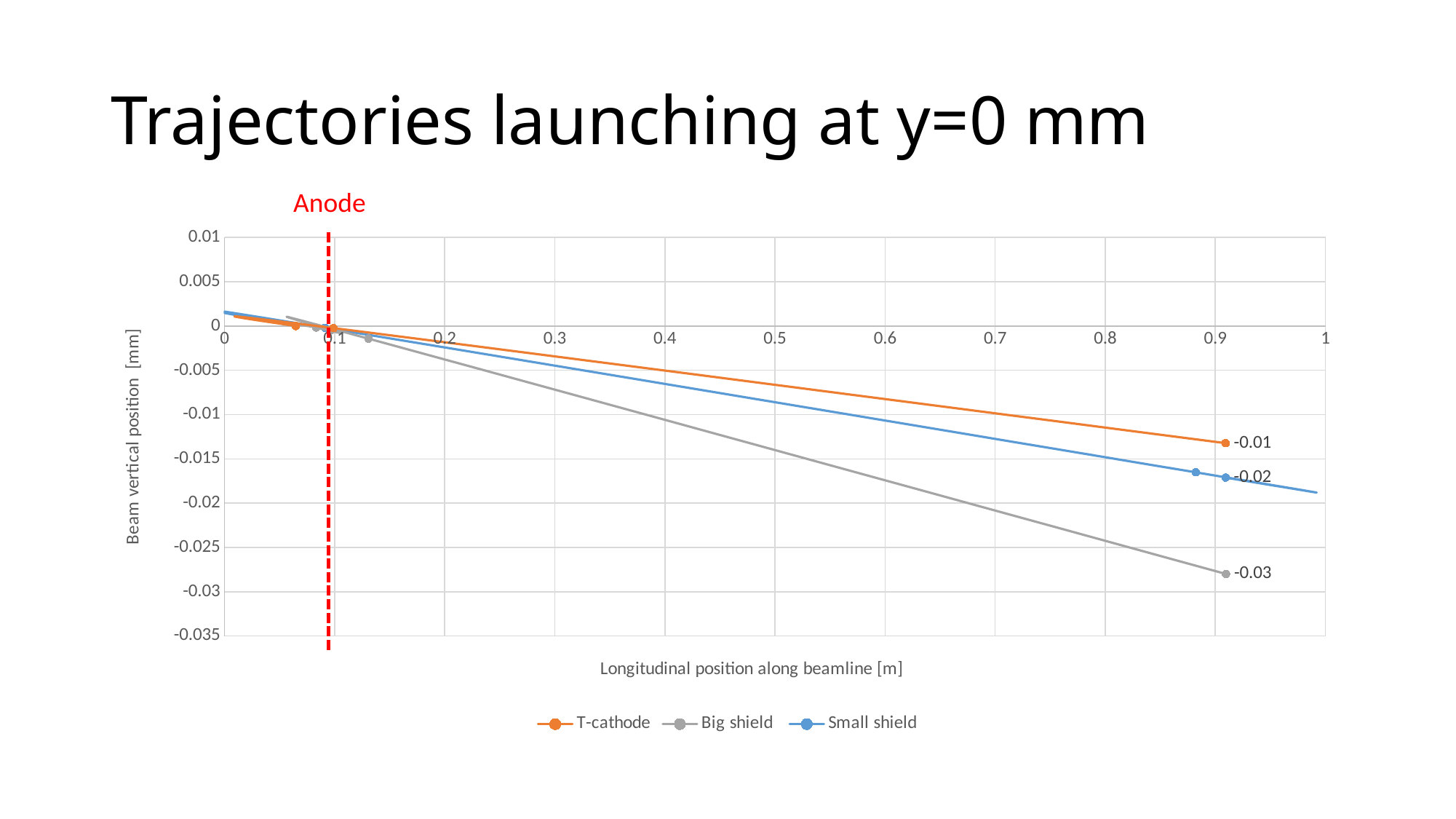
What data label is printed at the end of the Big shield line? -0.03 What are the three series named in the legend? T-cathode, Big shield, Small shield Which series has the lowest beam vertical position at the right end of the chart (around 0.9 m)? Big shield What data label is printed at the end of the Small shield line? -0.02 What label marks the red dashed vertical line near x = 0.1? Anode How many series does the legend list? 3 Do the beam vertical position values rise or fall as the longitudinal position increases? fall What data label is printed at the end of the T-cathode line? -0.01 At about 0.9 m, which is larger: the Small shield value or the Big shield value? Small shield Which series has the highest beam vertical position at the right end of the chart (around 0.9 m)? T-cathode What kind of chart is shown on the slide? line chart Is the Big shield value at about 0.9 m greater or less than -0.025? less